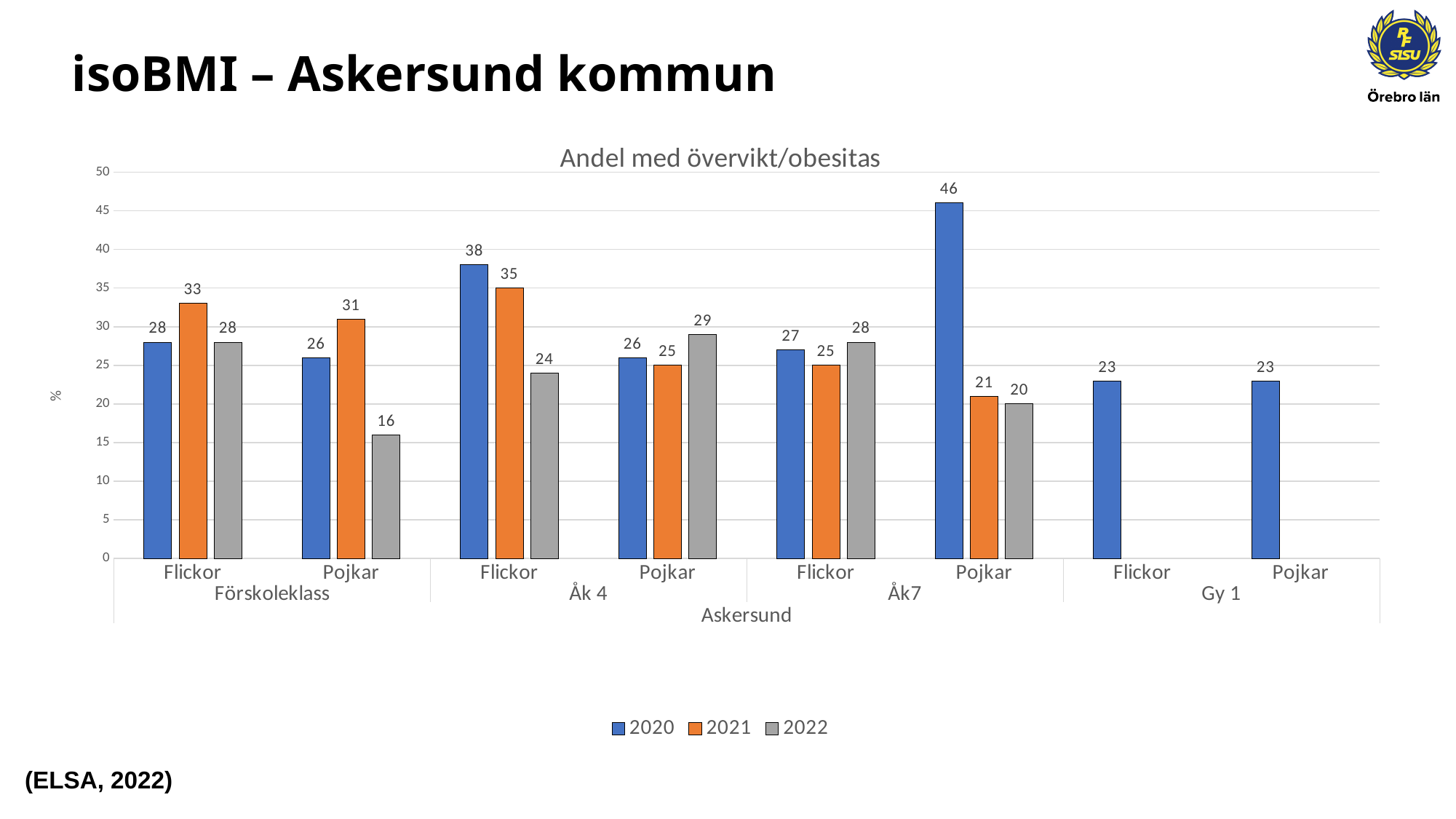
What kind of chart is shown on the slide? Bar chart How do the values for Pojkar in Åk7 change from 2020 to 2022? They fall What is the 2021 value for Flickor in Åk 4? 35 What is the difference between the 2020 and 2022 values for Flickor in Åk 4? 14 What is the 2020 value for Pojkar in Åk7? 46 What is the 2022 value for Pojkar in Förskoleklass? 16 What is the title of the chart? Andel med övervikt/obesitas Is the 2020 value for Flickor in Gy 1 greater or less than 25? less Which is larger for Pojkar in Åk 4: the 2021 value or the 2022 value? 2022 Which bar shows the lowest value in the chart? Pojkar, Förskoleklass, 2022 Which group and year has the highest value in the chart? Pojkar, Åk7, 2020 How many series does the legend list? 3